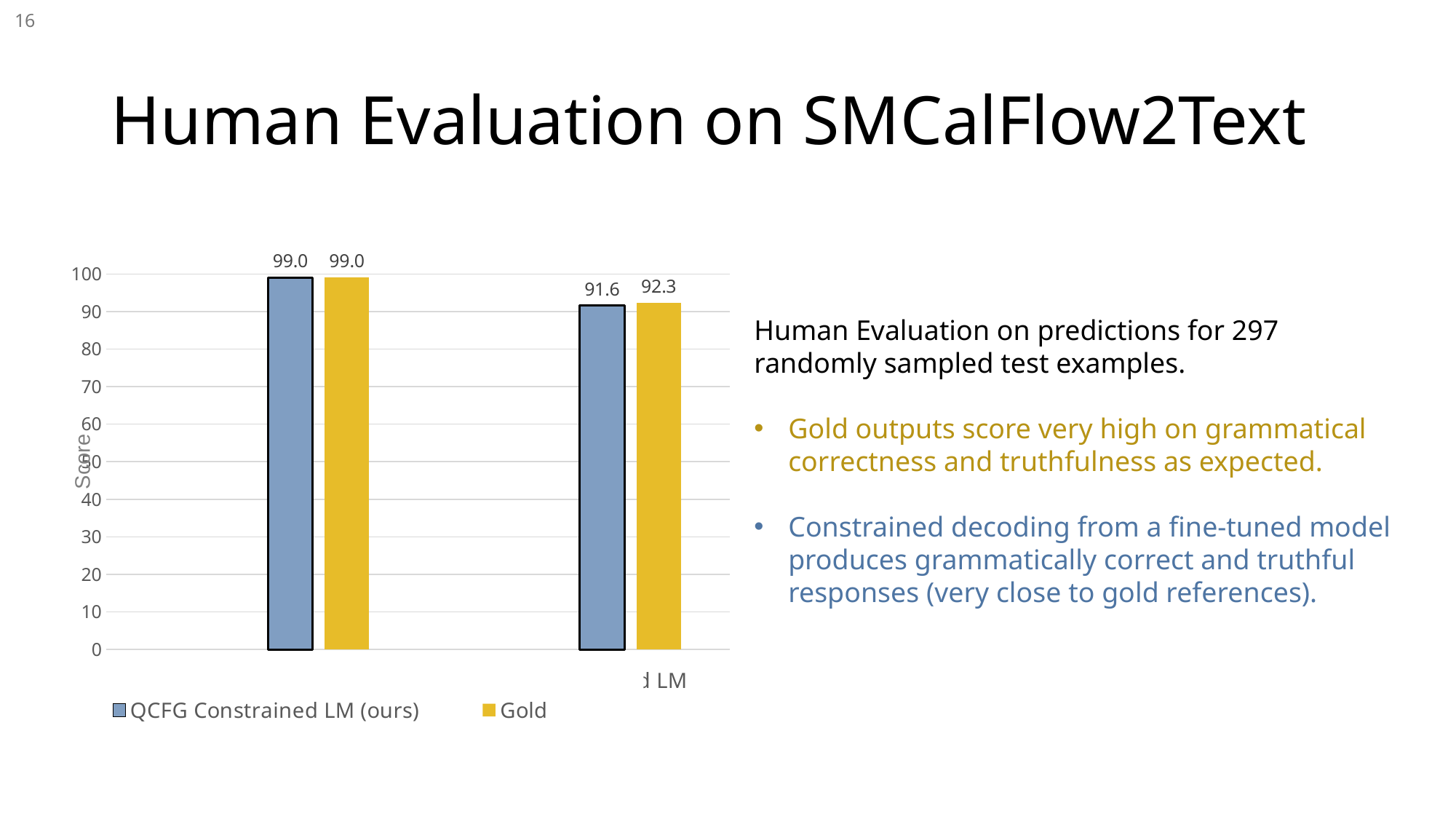
Which bar in the chart has the lowest value? QCFG Constrained LM (ours) in the right group (91.6) How many series does the chart legend list? 2 Is the value of the QCFG Constrained LM (ours) bar in the right group greater or less than 90? greater What is the value of the QCFG Constrained LM (ours) bar in the left group of bars? 99.0 What is the value of the QCFG Constrained LM (ours) bar in the right group of bars? 91.6 What is the value of the Gold bar in the right group of bars? 92.3 What is the label on the vertical axis of the chart? Score What type of chart is shown on the slide? bar chart What is the value of the Gold bar in the left group of bars? 99.0 In the right group of bars, what is the difference between the Gold value and the QCFG Constrained LM (ours) value? 0.7 What are the two series named in the chart legend? QCFG Constrained LM (ours) and Gold In the right group of bars, which series has the larger value, QCFG Constrained LM (ours) or Gold? Gold